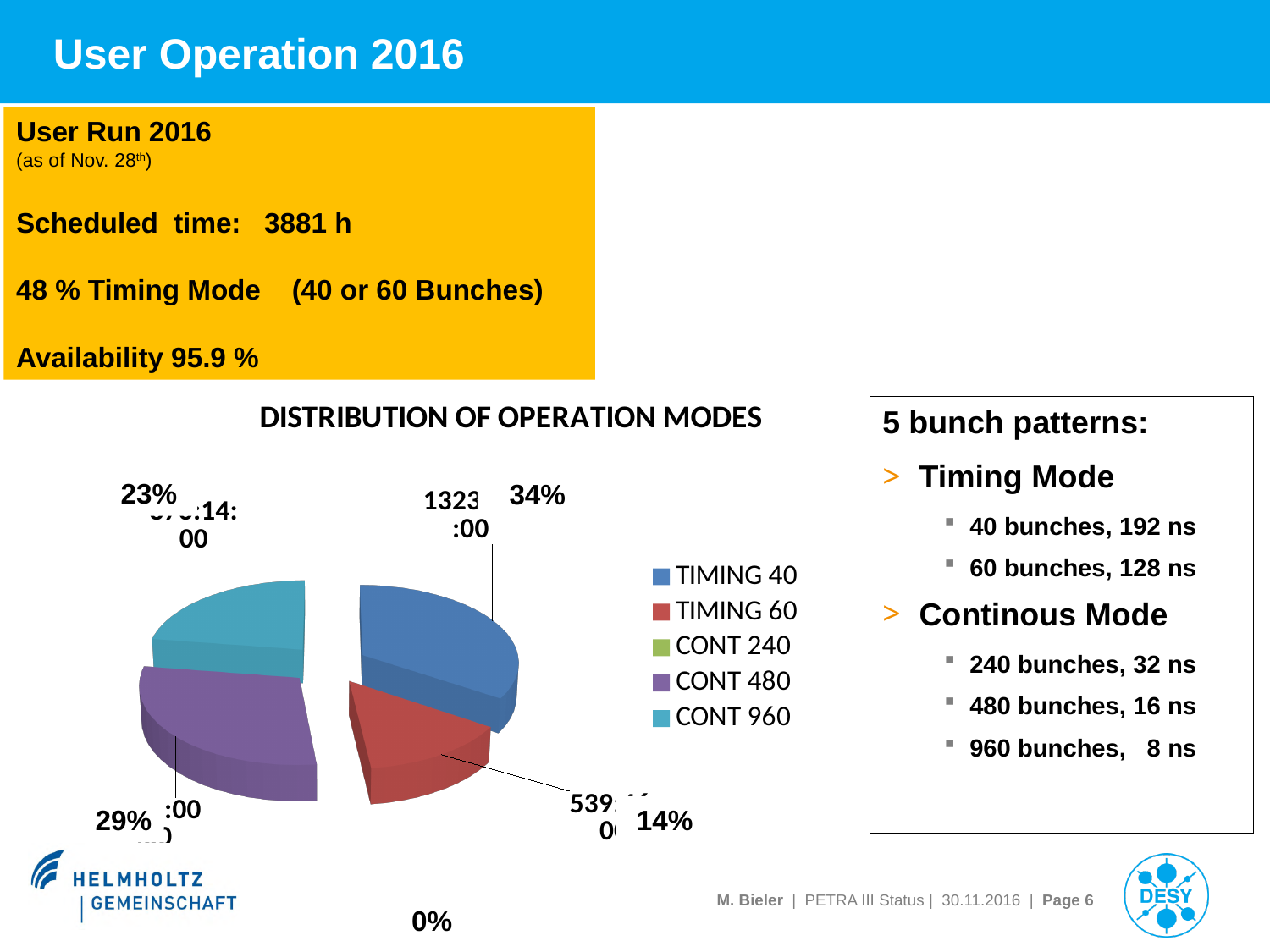
What share of the pie does TIMING 60 have? 14% What is the title of the pie chart? DISTRIBUTION OF OPERATION MODES Which has a larger share of the pie, CONT 480 or CONT 960? CONT 480 What share of the pie does CONT 960 have? 23% Which operation mode has the smallest share of the pie? CONT 240 What share of the pie does CONT 240 have? 0% What is the difference in percentage points between the shares of TIMING 40 and TIMING 60? 20 How many entries does the legend of the pie chart list? 5 Which operation mode has the largest share of the pie? TIMING 40 What type of chart is shown under the title "DISTRIBUTION OF OPERATION MODES"? pie chart